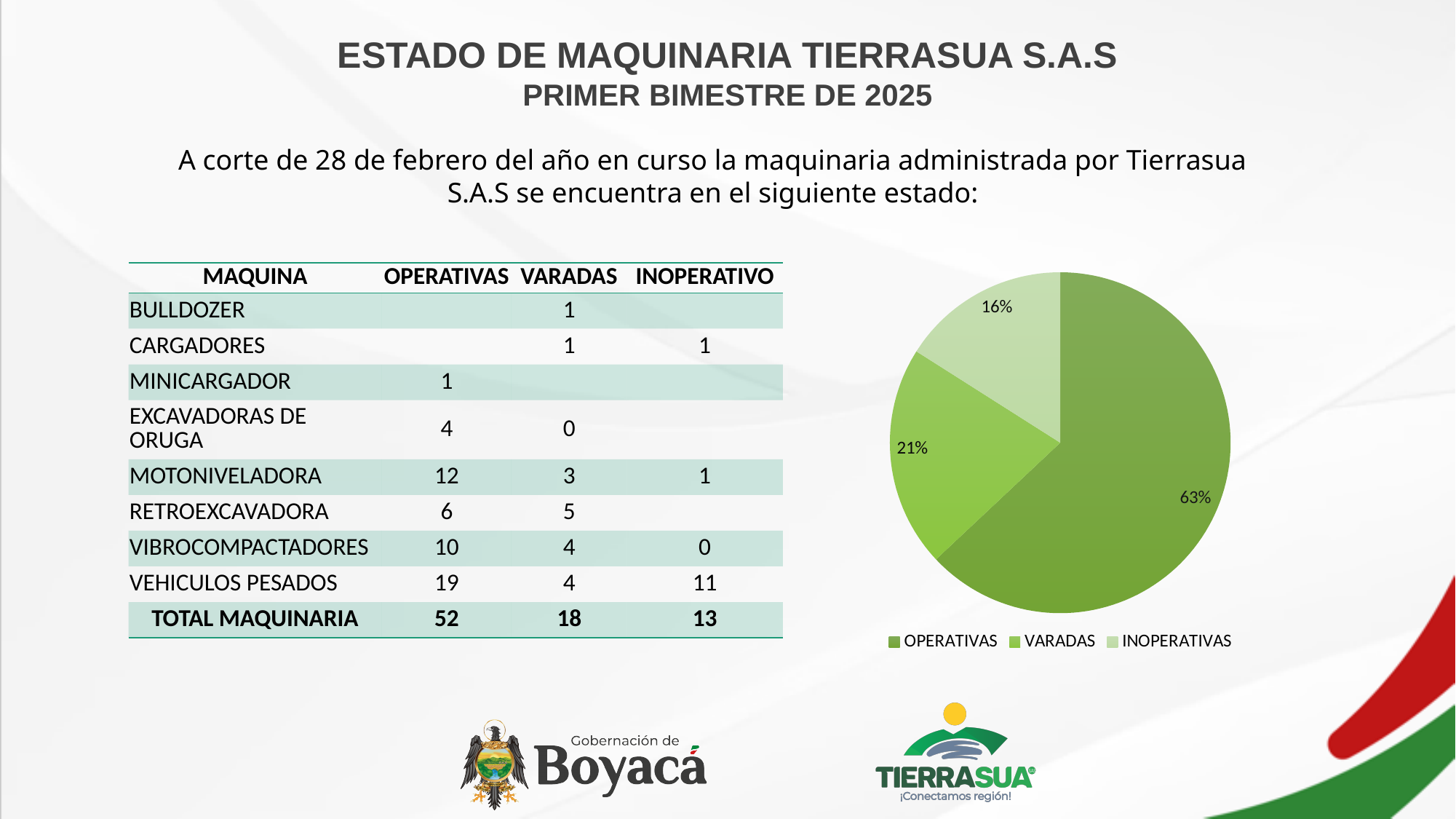
What share of the pie chart is INOPERATIVAS? 16% What kind of chart is shown on the slide? Pie chart What share of the pie chart is OPERATIVAS? 63% What is the difference in percentage points between the OPERATIVAS and VARADAS slices? 42 What is the difference in percentage points between the VARADAS and INOPERATIVAS slices? 5 Which slice of the pie chart is the largest? OPERATIVAS How many slices does the pie chart have? 3 How many entries does the pie chart legend list? 3 Which legend entry is shown in the lightest green colour? INOPERATIVAS What share of the pie chart is VARADAS? 21% Which slice of the pie chart is the smallest? INOPERATIVAS Which slice is larger, VARADAS or INOPERATIVAS? VARADAS